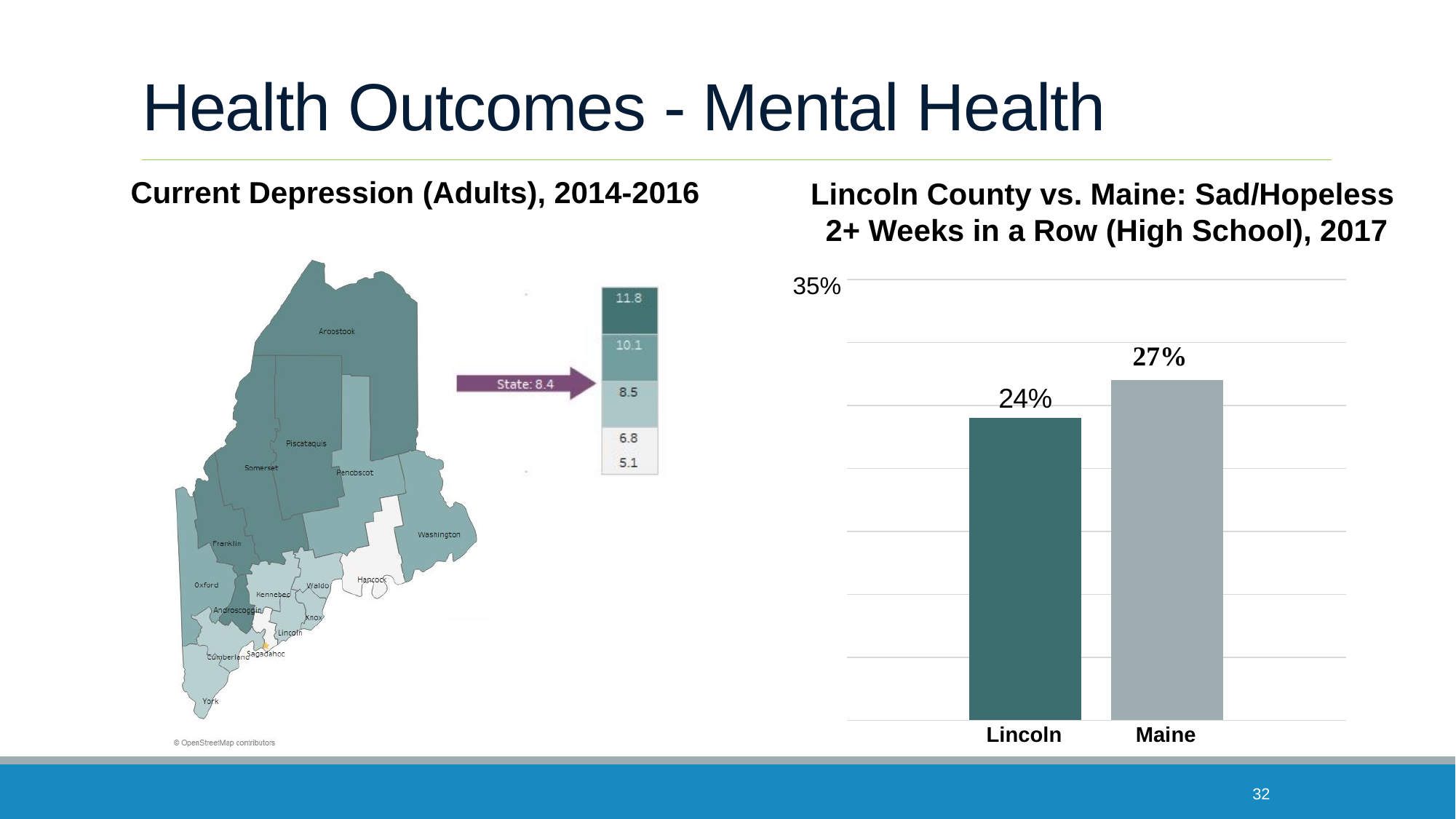
In the 'Lincoln County vs. Maine: Sad/Hopeless 2+ Weeks in a Row (High School), 2017' chart, what is the difference between the Maine and Lincoln values? 3% In the 'Lincoln County vs. Maine: Sad/Hopeless 2+ Weeks in a Row (High School), 2017' chart, is the value for Lincoln or Maine larger? Maine In the 'Lincoln County vs. Maine: Sad/Hopeless 2+ Weeks in a Row (High School), 2017' chart, which category has the highest value? Maine In the 'Lincoln County vs. Maine: Sad/Hopeless 2+ Weeks in a Row (High School), 2017' chart, what is the value for Maine? 27% On the 'Current Depression (Adults), 2014-2016' map, what state value is shown by the arrow label? State: 8.4 What kind of chart is the 'Lincoln County vs. Maine: Sad/Hopeless 2+ Weeks in a Row (High School), 2017' chart? bar chart What is the title of the chart on the right side of the slide? Lincoln County vs. Maine: Sad/Hopeless 2+ Weeks in a Row (High School), 2017 In the 'Lincoln County vs. Maine: Sad/Hopeless 2+ Weeks in a Row (High School), 2017' chart, which category has the lowest value? Lincoln In the 'Lincoln County vs. Maine: Sad/Hopeless 2+ Weeks in a Row (High School), 2017' chart, what is the value for Lincoln? 24% In the 'Lincoln County vs. Maine: Sad/Hopeless 2+ Weeks in a Row (High School), 2017' chart, is the value for Maine greater or less than 35%? less How many categories are shown in the 'Lincoln County vs. Maine: Sad/Hopeless 2+ Weeks in a Row (High School), 2017' chart? 2